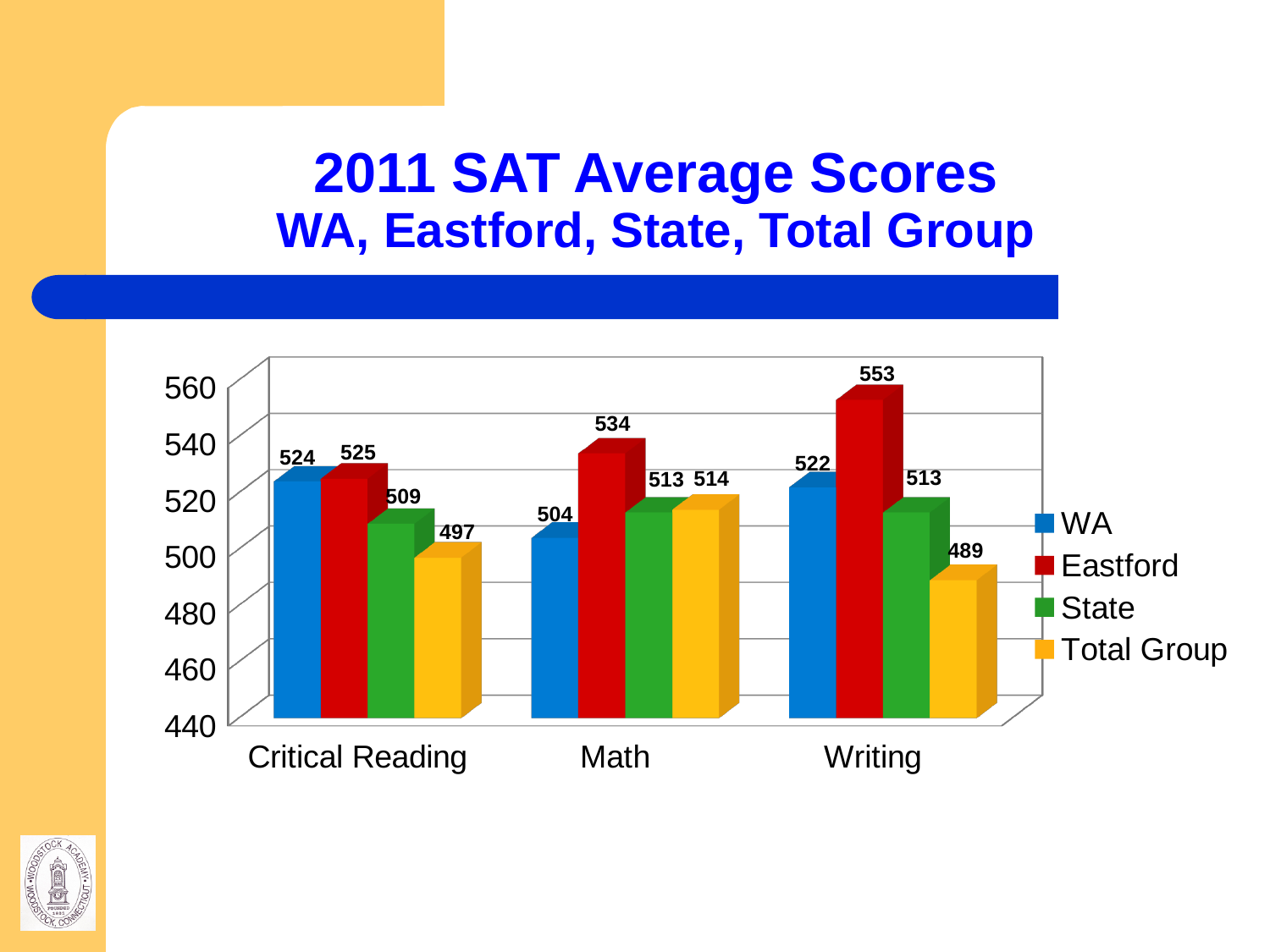
What is the WA average score for Critical Reading? 524 How many subject categories are shown on the x axis? 3 What kind of chart is shown on the slide? Bar chart Which series has the highest score for Writing? Eastford What is the difference between the Eastford and WA scores for Writing? 31 What is the Eastford average score for Math? 534 Which is larger, the WA score for Math or the State score for Math? State What is the Total Group average score for Writing? 489 Which series has the lowest score for Critical Reading? Total Group How many series does the legend list? 4 What is the State average score for Math? 513 Which colour represents Eastford in the legend? Red